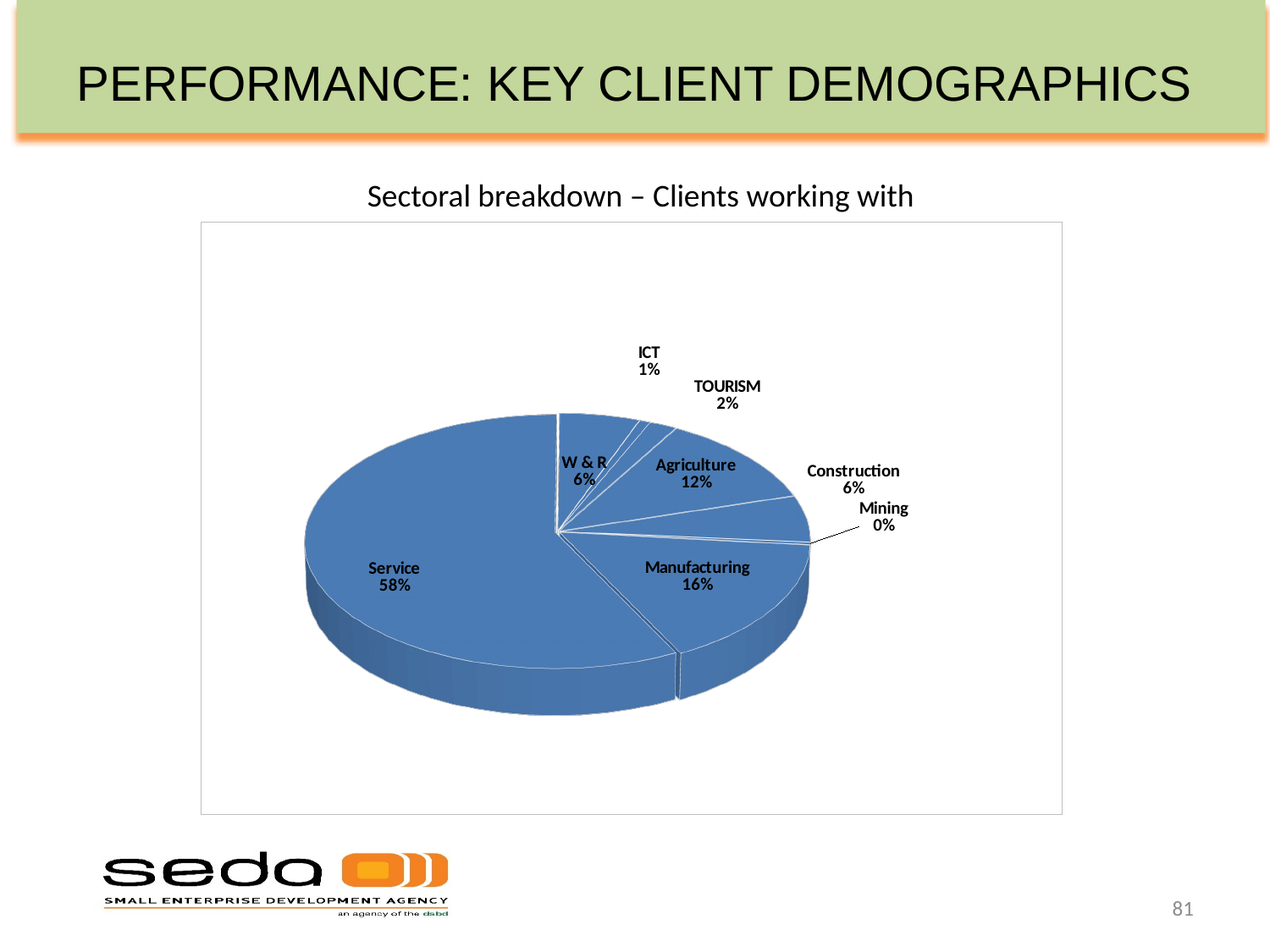
What percentage is shown for Mining? 0% Which sector has the largest share of the pie? Service What is the title of the chart? Sectoral breakdown – Clients working with What type of chart is shown on the slide? Pie chart What percentage is shown for Agriculture? 12% Which is larger, the share for TOURISM or the share for ICT? TOURISM What percentage is shown for Manufacturing? 16% How many sectors are shown in the pie chart? 8 What is the difference in percentage points between Manufacturing and Agriculture? 4 What share of clients is in the Service sector? 58% What percentage is shown for Construction? 6% Which sector has the smallest share of the pie? Mining